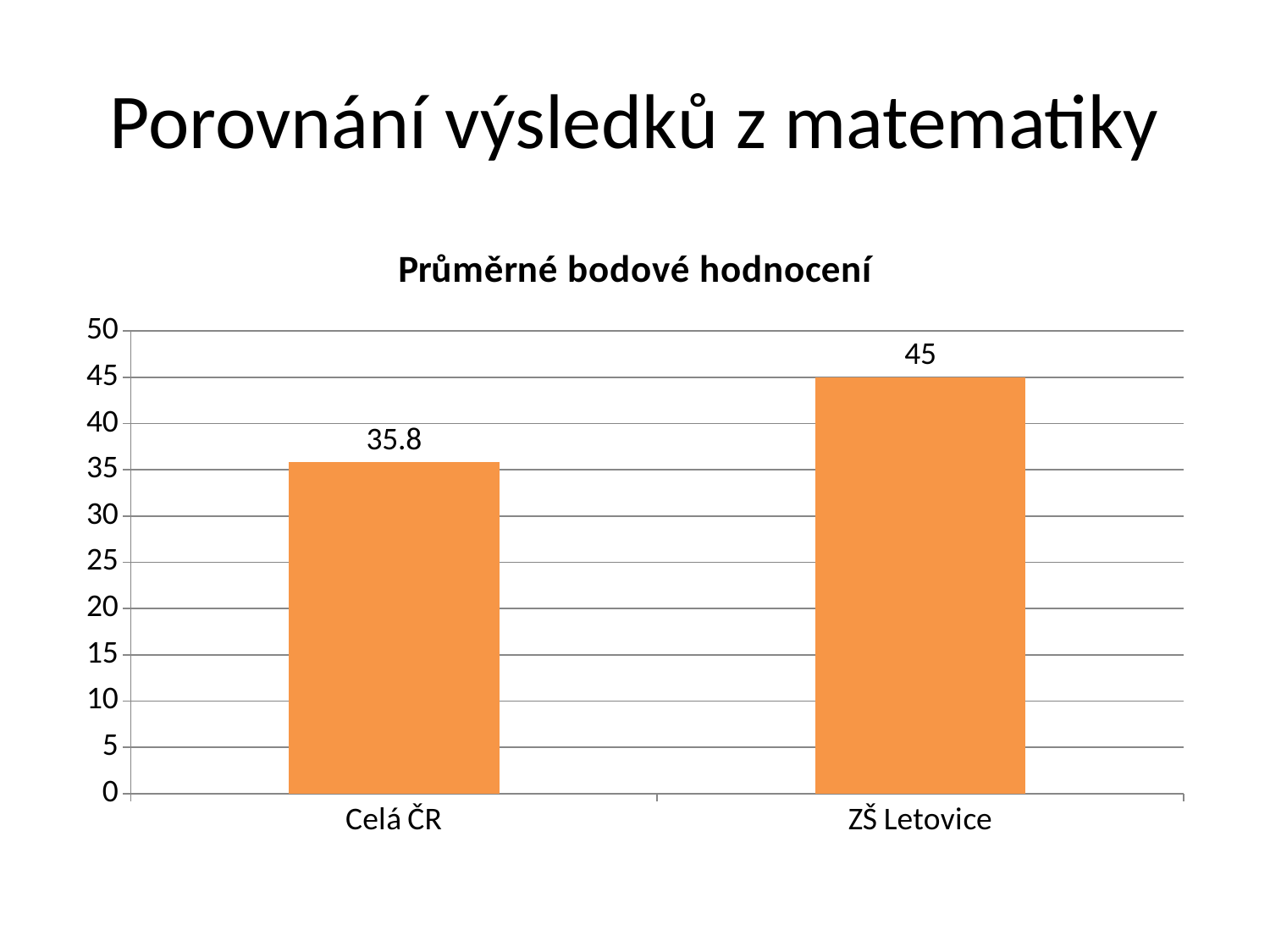
What is the difference between the values for ZŠ Letovice and Celá ČR? 9.2 Which category has the lowest value? Celá ČR What is the title of the chart? Průměrné bodové hodnocení What is the value for Celá ČR? 35.8 Which is larger, the value for Celá ČR or the value for ZŠ Letovice? ZŠ Letovice What kind of chart is shown on the slide? bar chart How many categories are shown in the chart? 2 Is the value for Celá ČR greater or less than 40? less Is the value for ZŠ Letovice greater or less than 40? greater What colour are the bars in the chart? orange What is the value for ZŠ Letovice? 45 Which category has the highest value? ZŠ Letovice